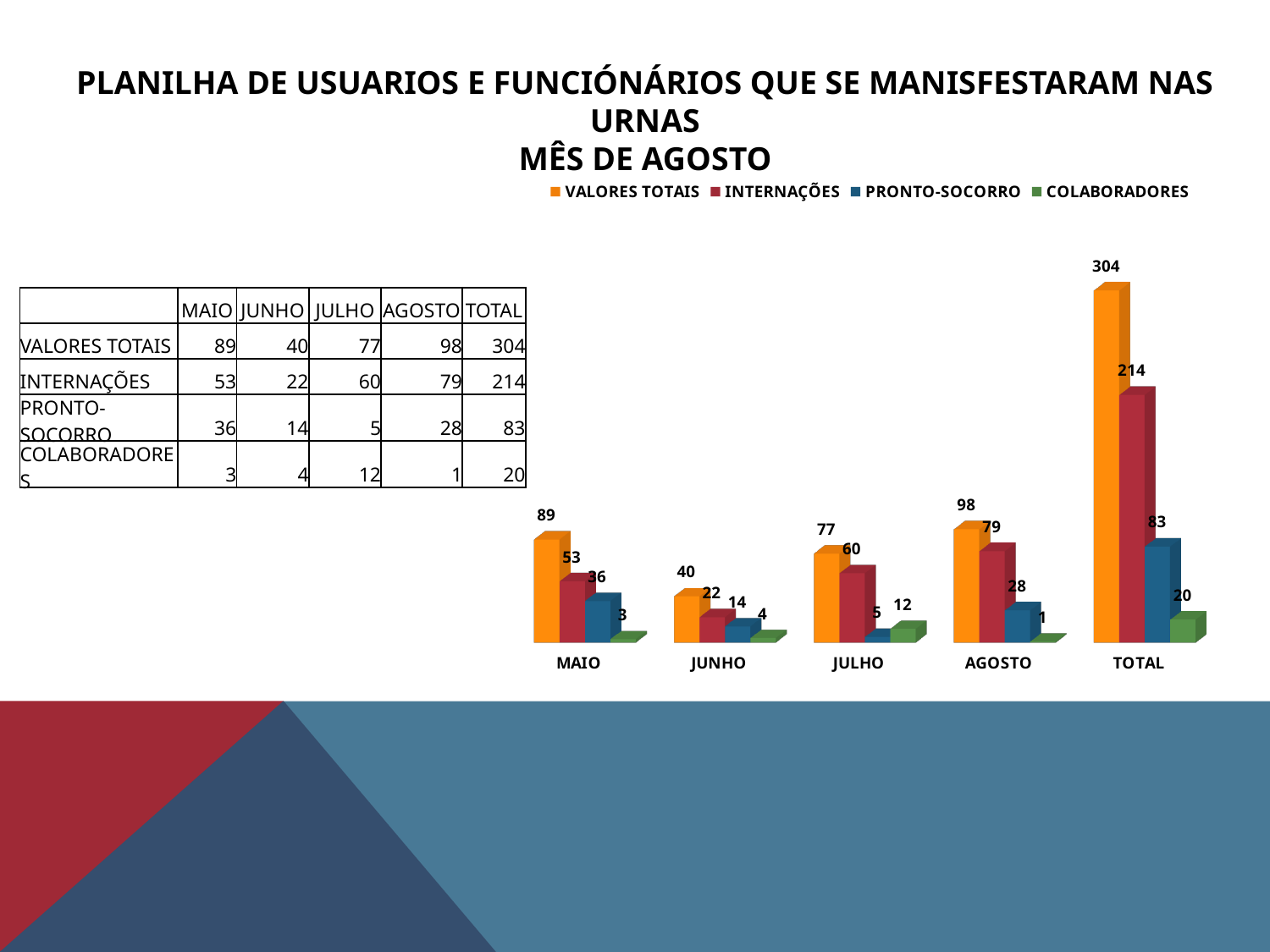
What is the value of VALORES TOTAIS for AGOSTO in the chart? 98 What is the value of COLABORADORES for TOTAL in the chart? 20 What is the value of INTERNAÇÕES for JULHO in the chart? 60 What type of chart is shown on the slide? Bar chart How many categories are shown on the x axis of the chart? 5 Which is larger: PRONTO-SOCORRO for JULHO or COLABORADORES for JULHO? COLABORADORES for JULHO Among the months MAIO, JUNHO, JULHO and AGOSTO, which has the highest INTERNAÇÕES value? AGOSTO What is the value of PRONTO-SOCORRO for MAIO in the chart? 36 Which colour represents the INTERNAÇÕES series in the chart? Red What is the difference between the VALORES TOTAIS values for AGOSTO and JUNHO? 58 How many series does the chart legend list? 4 Among the months MAIO, JUNHO, JULHO and AGOSTO, which has the lowest VALORES TOTAIS value? JUNHO